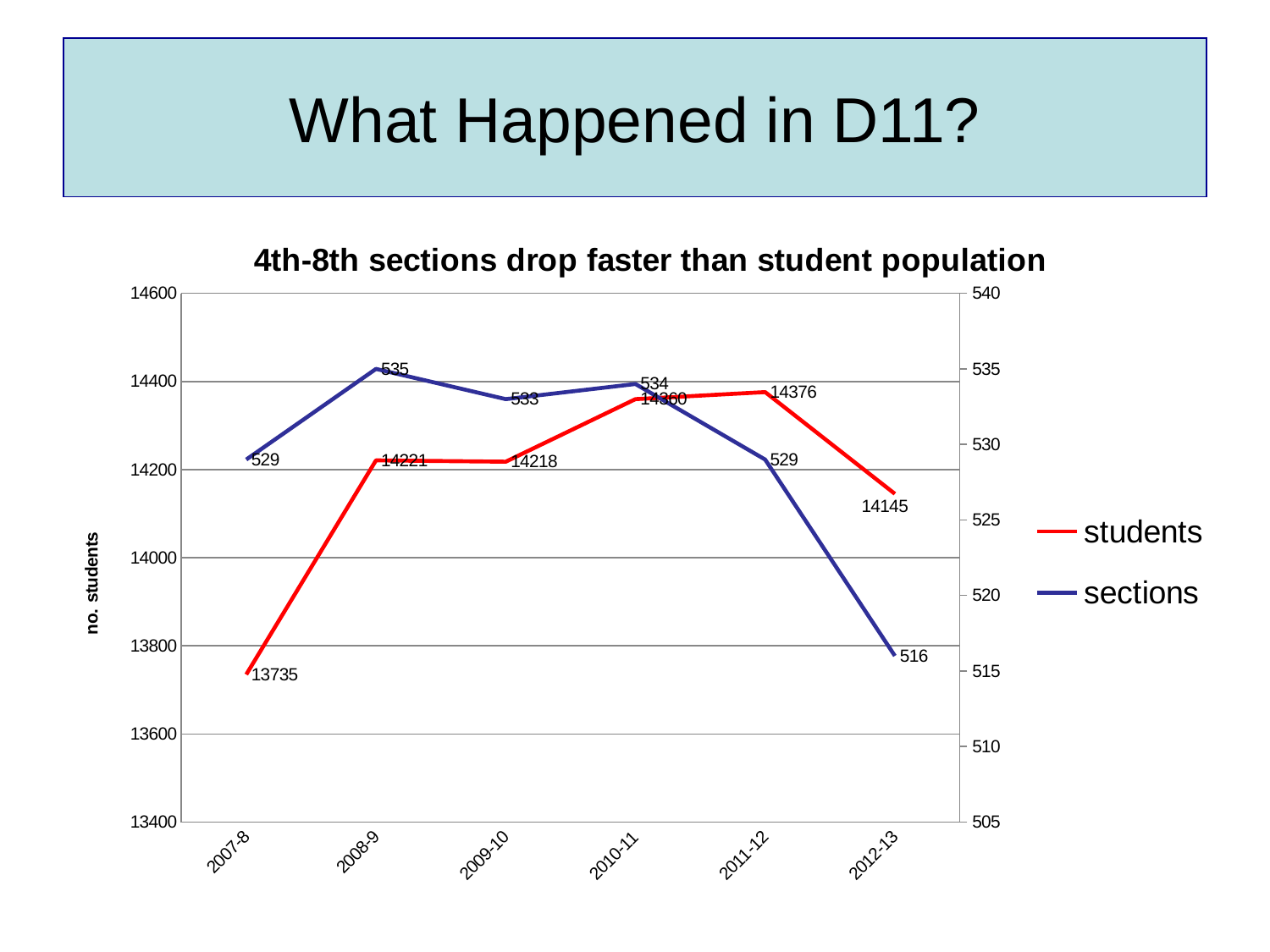
How many series does the legend list? 2 What is the number of students in 2011-12? 14376 In which year is the number of students lowest? 2007-8 How many school years are plotted on the x axis? 6 What is the number of sections in 2012-13? 516 What is the difference between the number of sections in 2008-9 and in 2012-13? 19 Which year has more sections, 2009-10 or 2011-12? 2009-10 Do the number of sections rise or fall from 2011-12 to 2012-13? Fall What is the number of students in 2007-8? 13735 In which year is the number of sections highest? 2008-9 What kind of chart is shown on the slide? Line chart By how much did the number of students fall from 2011-12 to 2012-13? 231